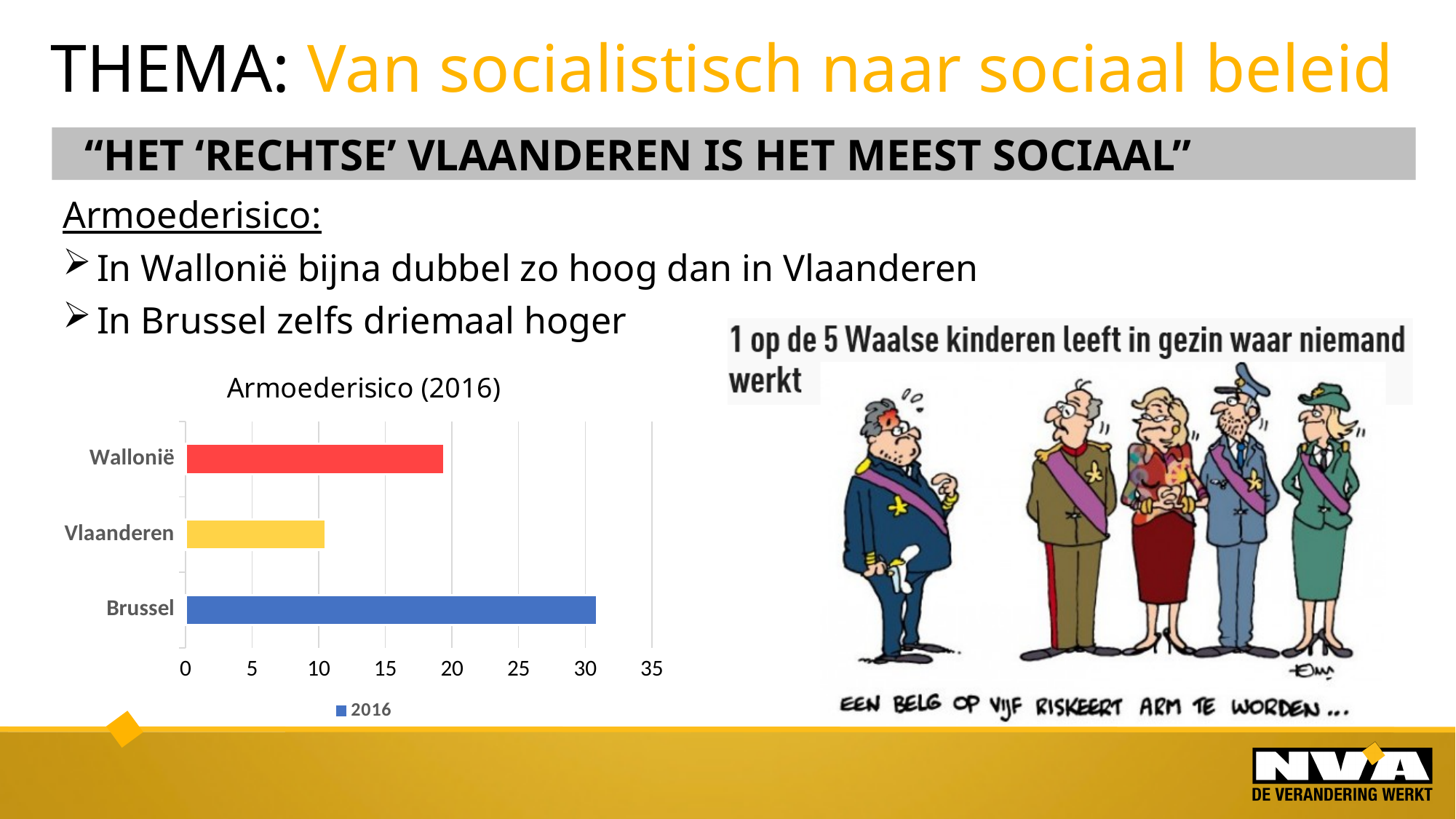
What is the title of the chart? Armoederisico (2016) Which category has the lowest value in the chart? Vlaanderen Is the value for Vlaanderen greater or less than 10? greater How many series does the legend list? 1 Which has a larger value, Wallonië or Vlaanderen? Wallonië What series name is shown in the chart legend? 2016 Which category has the highest value in the chart? Brussel Is the value for Wallonië greater or less than 20? less Which has a larger value, Brussel or Wallonië? Brussel Is the value for Brussel greater or less than 30? greater How many categories does the chart show? 3 What kind of chart is shown on the slide? bar chart